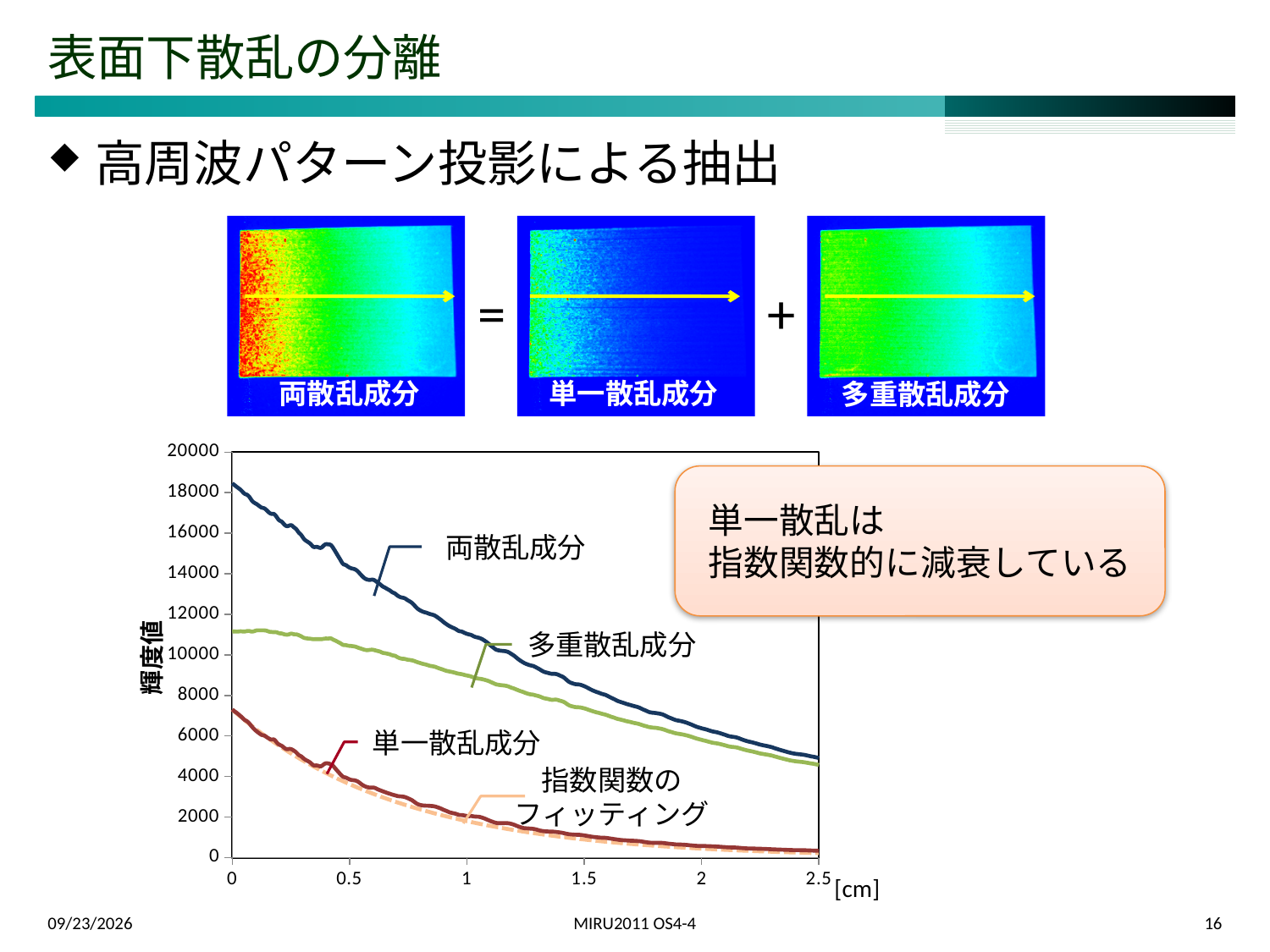
Is the value of 単一散乱成分 at x = 2.5 greater or less than 2000? less At x = 1, which is larger: 多重散乱成分 or 単一散乱成分? 多重散乱成分 Is the value of 両散乱成分 at x = 2.5 greater or less than 6000? less Is the value of 両散乱成分 at x = 0 greater or less than 16000? greater Does the 両散乱成分 line rise or fall as the x value increases from 0 to 2.5? fall What kind of chart is shown on the slide? line chart Which line has the highest value at x = 0? 両散乱成分 What is the label of the vertical axis of the chart? 輝度値 Does the 単一散乱成分 line rise or fall along the x axis? fall How many labeled lines are plotted in the chart? 4 What unit is shown for the horizontal axis of the chart? cm